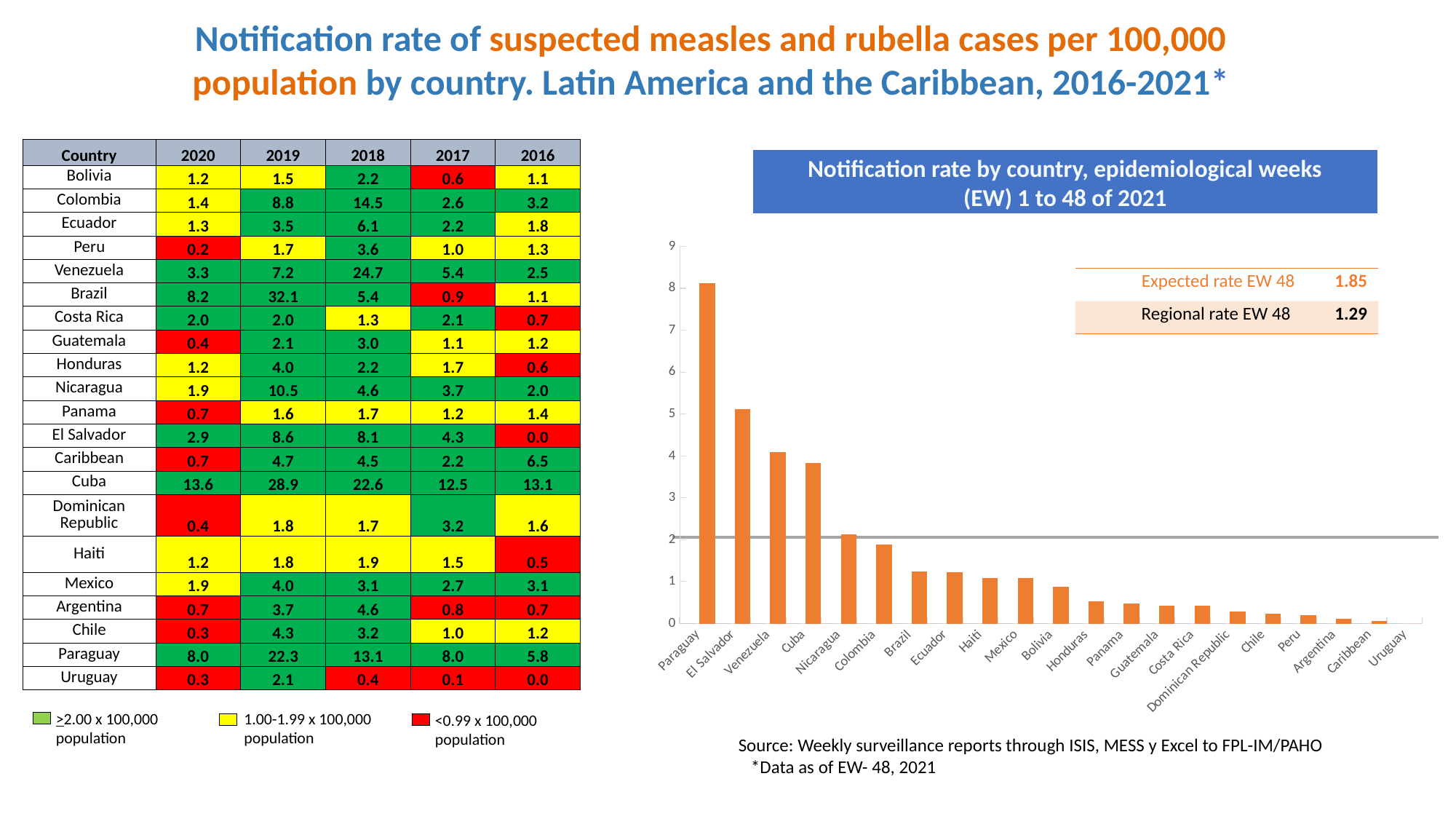
In the bar chart on the right, is the value for Brazil greater or less than 2? less In the bar chart on the right, which has the larger value, Venezuela or Cuba? Venezuela What is the Expected rate EW 48 shown on the bar chart on the right? 1.85 How many countries are shown on the x axis of the bar chart on the right? 21 What kind of chart is shown on the right side of the slide? bar chart In the bar chart on the right, is the value for Honduras greater or less than 1? less In the bar chart on the right, do the values rise or fall from left to right along the x axis? fall In the bar chart on the right, is the value for Paraguay greater or less than 7? greater In the bar chart on the right, which has the larger value, Cuba or Nicaragua? Cuba In the bar chart 'Notification rate by country, epidemiological weeks (EW) 1 to 48 of 2021', which country has the highest notification rate? Paraguay In the bar chart 'Notification rate by country, epidemiological weeks (EW) 1 to 48 of 2021', which country has the lowest notification rate? Uruguay